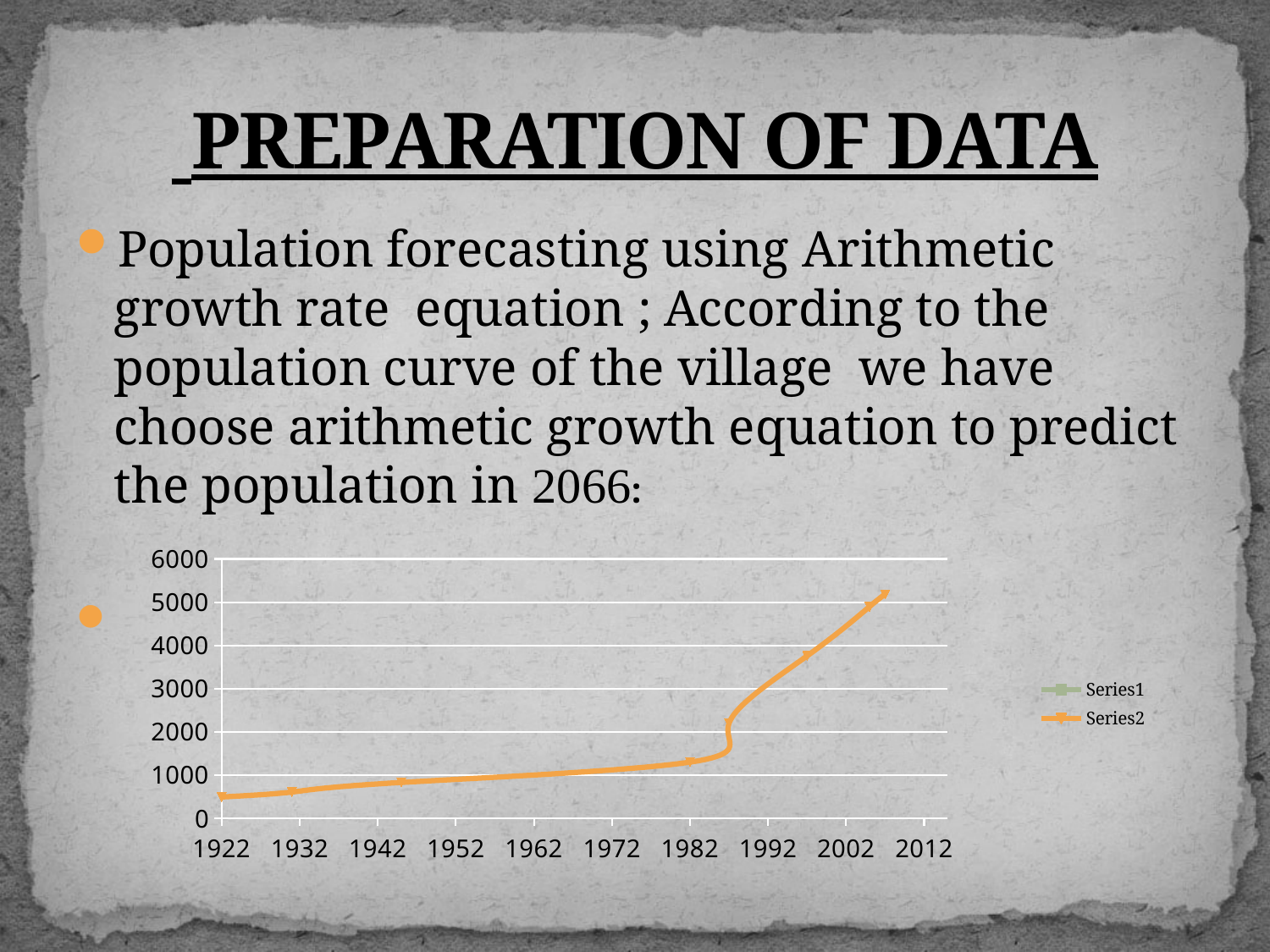
Is the value for 1922 greater or less than 1000? less What is the highest value shown on the y axis? 6000 What kind of chart is shown on the slide? line chart How many year labels are shown on the x axis? 10 How many series does the chart legend list? 2 Do the plotted values rise or fall from 1922 to 2012 along the x axis? rise What are the names of the series listed in the chart legend? Series1 and Series2 Which year has the higher value, 1932 or 2002? 2002 Is the value for 1982 greater or less than 1000? greater Is the value for 1982 greater or less than 2000? less